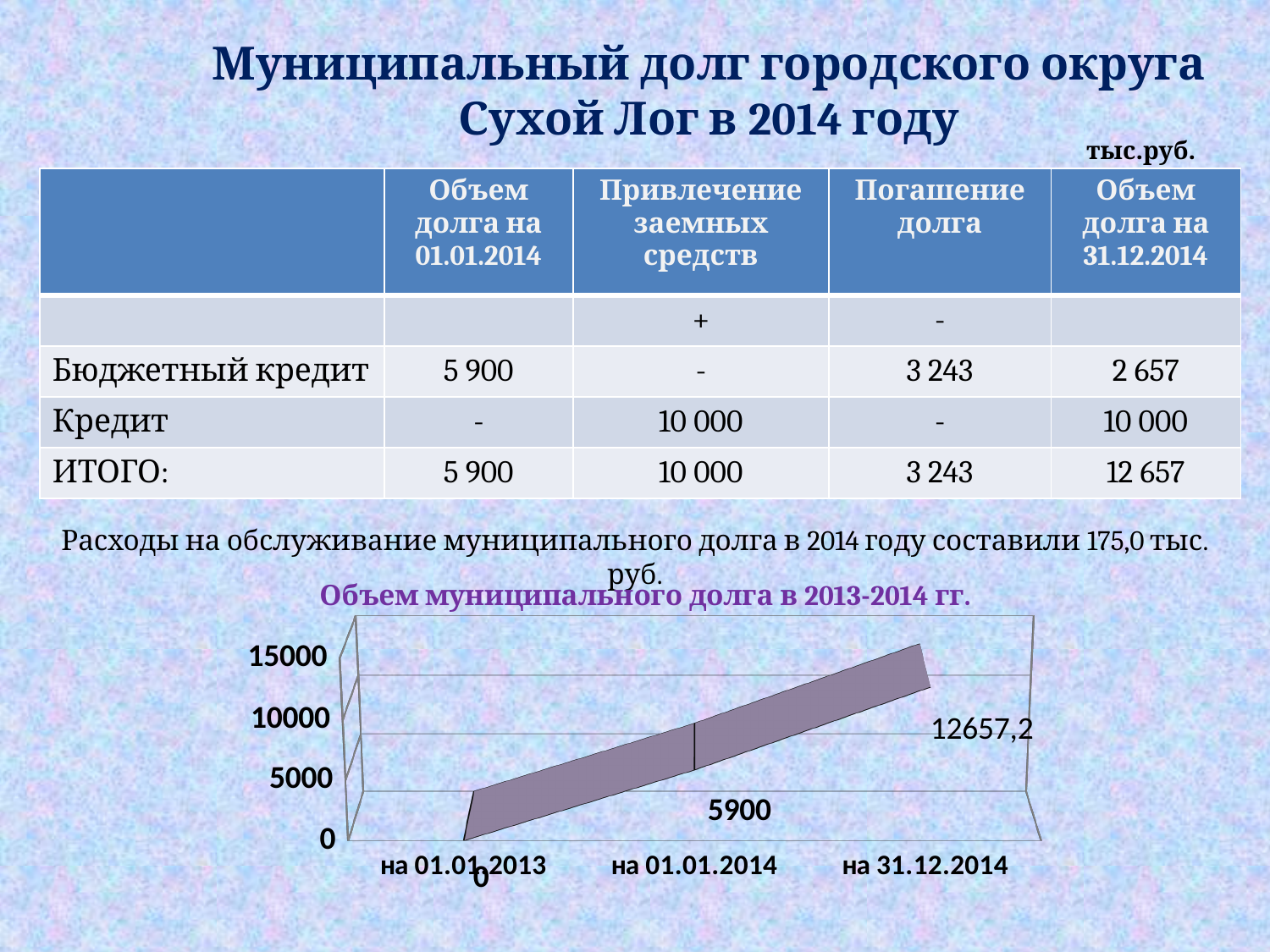
What kind of chart is 'Объем муниципального долга в 2013-2014 гг.'? line chart What is the value for на 31.12.2014 in the chart 'Объем муниципального долга в 2013-2014 гг.'? 12657,2 What is the value for на 01.01.2014 in the chart 'Объем муниципального долга в 2013-2014 гг.'? 5900 What is the title of the chart on the slide? Объем муниципального долга в 2013-2014 гг. In the chart 'Объем муниципального долга в 2013-2014 гг.', which is larger: the value for на 01.01.2014 or the value for на 31.12.2014? на 31.12.2014 Which date has the highest value in the chart 'Объем муниципального долга в 2013-2014 гг.'? на 31.12.2014 Which date has the lowest value in the chart 'Объем муниципального долга в 2013-2014 гг.'? на 01.01.2013 In the chart 'Объем муниципального долга в 2013-2014 гг.', what is the difference between the values for на 31.12.2014 and на 01.01.2014? 6757,2 What is the value for на 01.01.2013 in the chart 'Объем муниципального долга в 2013-2014 гг.'? 0 In the chart 'Объем муниципального долга в 2013-2014 гг.', is the value for на 31.12.2014 greater or less than 10000? greater How many data points are plotted in the chart 'Объем муниципального долга в 2013-2014 гг.'? 3 Do the values in the chart 'Объем муниципального долга в 2013-2014 гг.' rise or fall from left to right along the x axis? rise